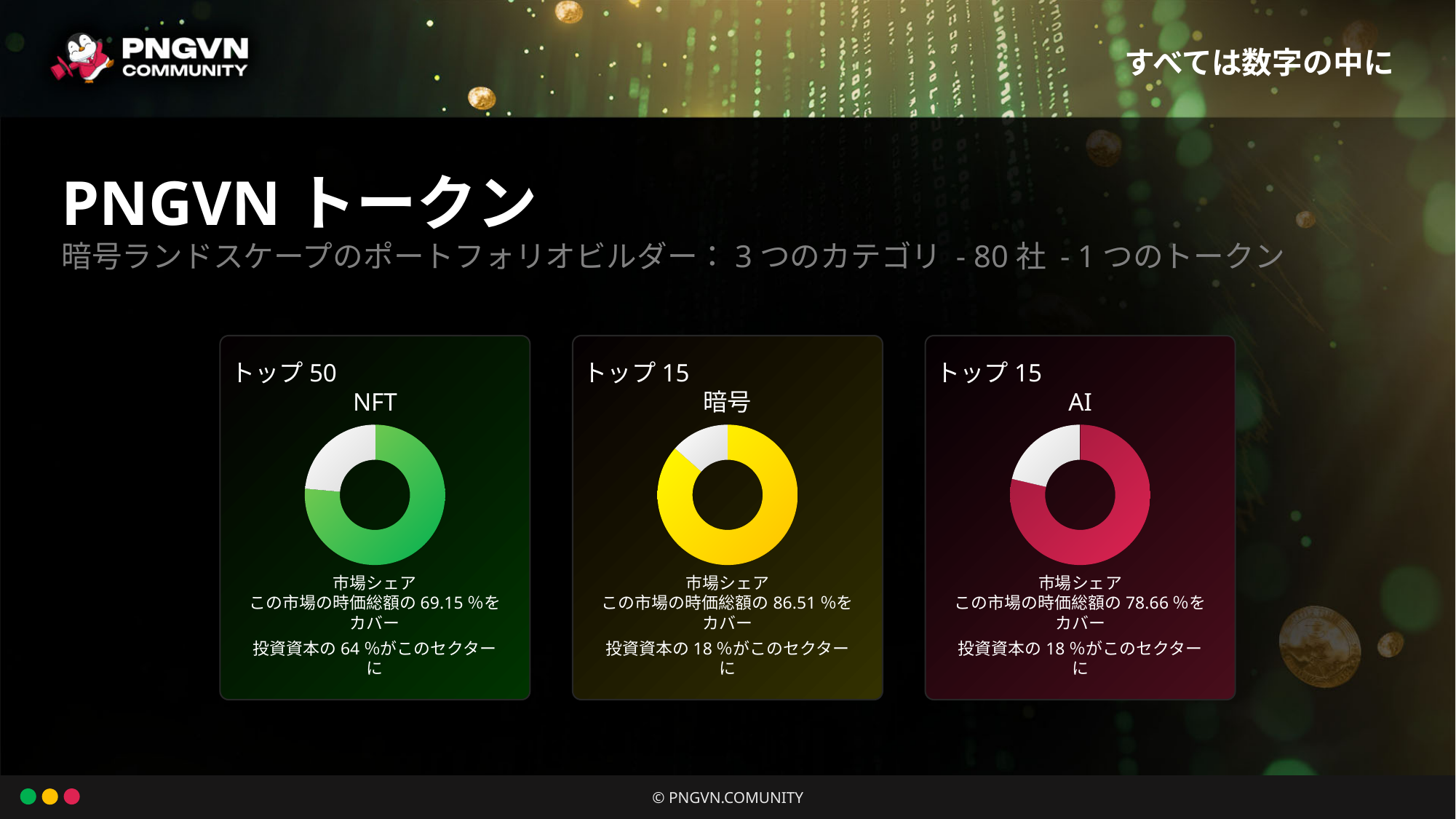
How many charts are shown on the slide? 3 Which reports a larger market capitalization coverage, the NFT chart card or the AI chart card? AI In the 暗号 chart card, what percentage of the market's total capitalization is covered according to the text below the chart? 86.51 % In the NFT chart card, what percentage of invested capital goes to this sector? 64 % In the AI chart card, what percentage of the market's total capitalization is covered according to the text below the chart? 78.66 % What is the difference in market capitalization coverage between the 暗号 chart card and the NFT chart card? 17.36 % Which of the three chart cards reports the highest market capitalization coverage? 暗号 Which of the three chart cards reports the lowest market capitalization coverage? NFT What colour is the main slice of the 暗号 chart? yellow In the AI chart card, what percentage of invested capital goes to this sector? 18 % In the NFT chart card, what percentage of the market's total capitalization is covered according to the text below the chart? 69.15 % What kind of chart is used in each of the three cards on the slide? pie chart (donut)